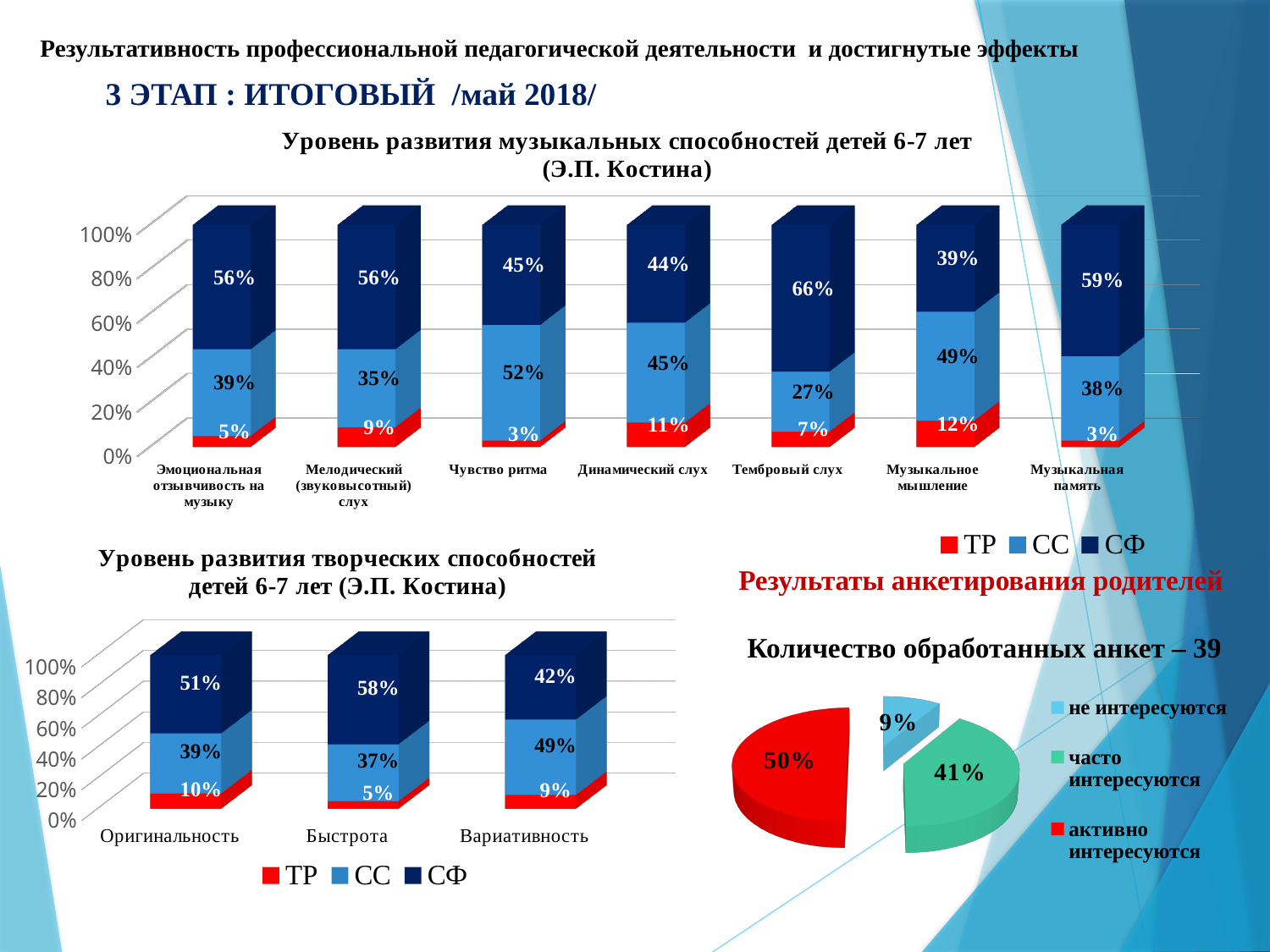
In the chart 'Уровень развития музыкальных способностей детей 6-7 лет', what is the ТР value for 'Музыкальное мышление'? 12% In the chart 'Уровень развития музыкальных способностей детей 6-7 лет', which is larger: the СС value for 'Музыкальное мышление' or the СС value for 'Музыкальная память'? Музыкальное мышление In the pie chart under 'Результаты анкетирования родителей', which slice is the smallest? не интересуются In the chart 'Уровень развития музыкальных способностей детей 6-7 лет', what is the difference between the СС values for 'Чувство ритма' and 'Тембровый слух'? 25% In the chart 'Уровень развития музыкальных способностей детей 6-7 лет', which category has the highest СФ value? Тембровый слух In the chart 'Уровень развития творческих способностей детей 6-7 лет', how many series does the legend list? 3 In the chart 'Уровень развития музыкальных способностей детей 6-7 лет', how many categories are shown on the x axis? 7 In the chart 'Уровень развития творческих способностей детей 6-7 лет', which category has the lowest ТР value? Быстрота In the chart 'Уровень развития творческих способностей детей 6-7 лет', what is the СФ value for 'Быстрота'? 58% In the pie chart under 'Результаты анкетирования родителей', what share of parents 'активно интересуются'? 50% What kind of chart is 'Уровень развития творческих способностей детей 6-7 лет'? Stacked bar chart In the chart 'Уровень развития музыкальных способностей детей 6-7 лет', what is the СФ value for 'Тембровый слух'? 66%